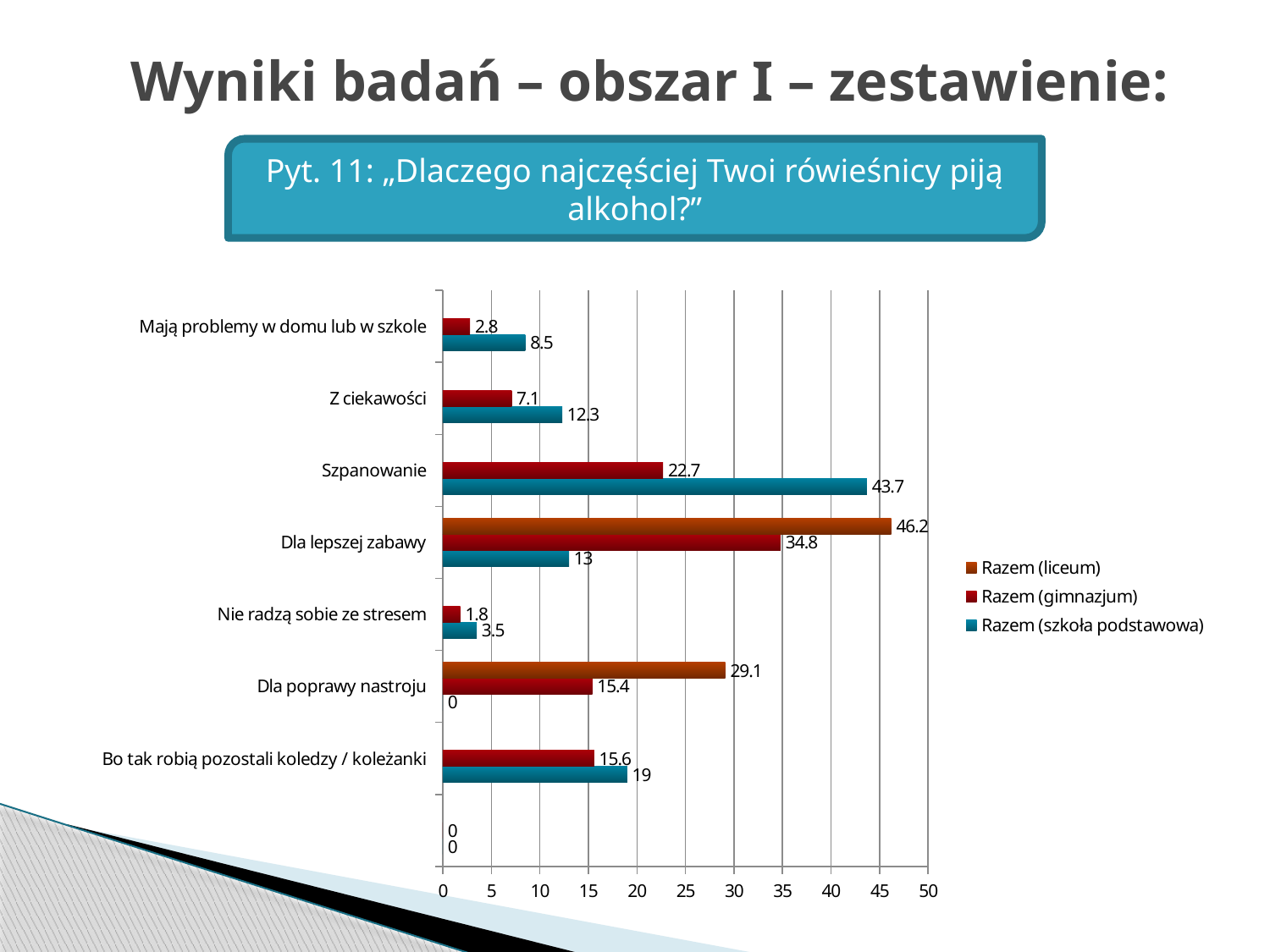
What kind of chart is shown on the slide? Bar chart What is the value for Razem (liceum) in the category Dla lepszej zabawy? 46.2 What is the value for Razem (szkoła podstawowa) in the category Bo tak robią pozostali koledzy / koleżanki? 19 What is the difference between the Razem (liceum) and Razem (gimnazjum) values for Dla lepszej zabawy? 11.4 Which category has the highest value for Razem (szkoła podstawowa)? Szpanowanie How many series does the legend list? 3 What is the value for Razem (gimnazjum) in the category Dla poprawy nastroju? 15.4 For Z ciekawości, which is larger: Razem (gimnazjum) or Razem (szkoła podstawowa)? Razem (szkoła podstawowa) What is the difference between the Razem (szkoła podstawowa) and Razem (gimnazjum) values for Szpanowanie? 21 What question is the chart about, as shown in the box above it? Pyt. 11: „Dlaczego najczęściej Twoi rówieśnicy piją alkohol?” What is the value for Razem (szkoła podstawowa) in the category Szpanowanie? 43.7